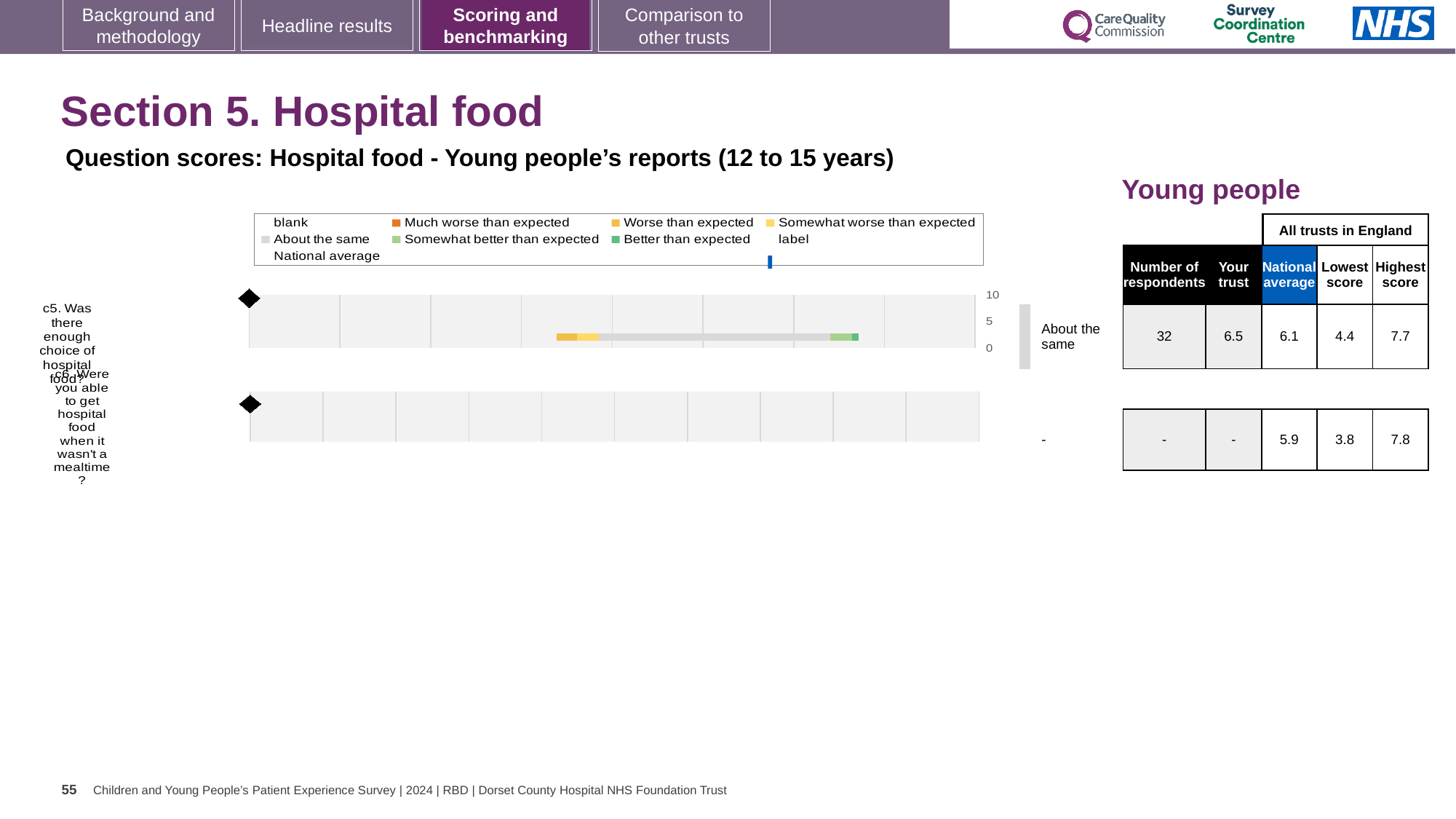
According to the table next to the chart, what is the 'Your trust' score for question c5 (enough choice of hospital food)? 6.5 How many survey questions (categories) are plotted on the chart? 2 What is the highest value shown on the chart's score axis? 10 What kind of chart is shown on the slide? bar chart How many entries does the chart legend list? 9 What colour is the 'Much worse than expected' legend entry? orange What benchmark category is given for question c5 beside the chart? About the same For question c5, which is larger: the 'Your trust' score or the national average? Your trust According to the table, how many respondents answered question c5? 32 For question c5, what is the difference between the highest score and the lowest score across all trusts in England? 3.3 According to the table next to the chart, what is the national average score for question c5? 6.1 For question c5, what is the difference between the 'Your trust' score and the national average? 0.4